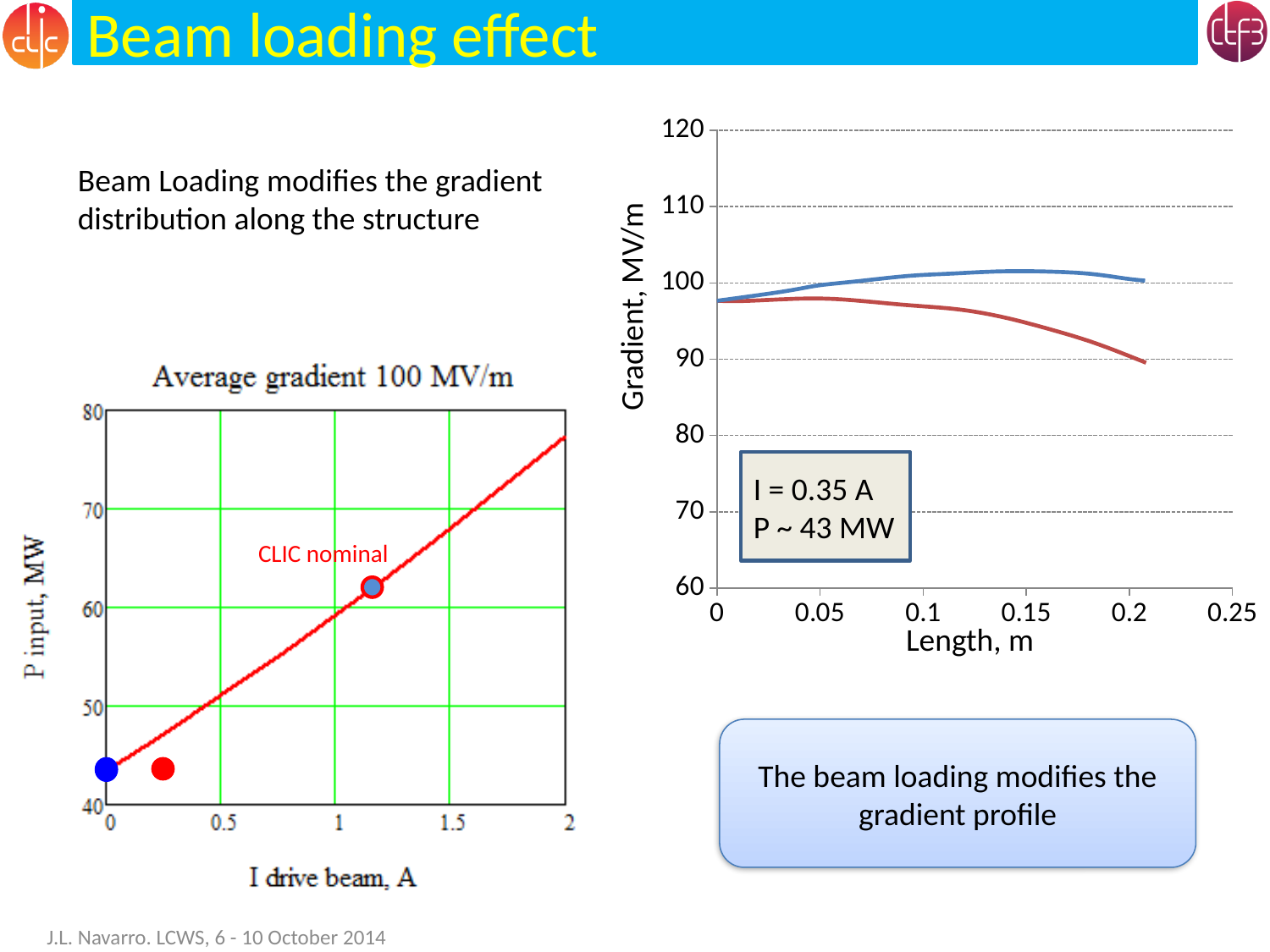
In the left chart titled "Average gradient 100 MV/m", does P input rise or fall as I drive beam increases? rises What kind of chart is the left chart titled "Average gradient 100 MV/m"? line chart In the left chart titled "Average gradient 100 MV/m", is the P input value of the blue dot at I drive beam = 0 greater or less than 50? less In the right chart (Gradient vs Length), what is the label of the y axis? Gradient, MV/m In the right chart (Gradient vs Length), is the red curve's gradient at Length 0.15 m greater or less than 100? less In the right chart (Gradient vs Length), at Length 0.15 m, which curve has the higher gradient, the blue or the red? blue In the left chart titled "Average gradient 100 MV/m", what is the label of the x axis? I drive beam, A In the left chart titled "Average gradient 100 MV/m", is the P input value at the point labelled "CLIC nominal" greater or less than 60? greater In the right chart (Gradient vs Length), how many curves are plotted? 2 In the right chart (Gradient vs Length), what is the maximum value shown on the y axis? 120 In the right chart (Gradient vs Length), does the red curve rise or fall overall as Length increases? falls